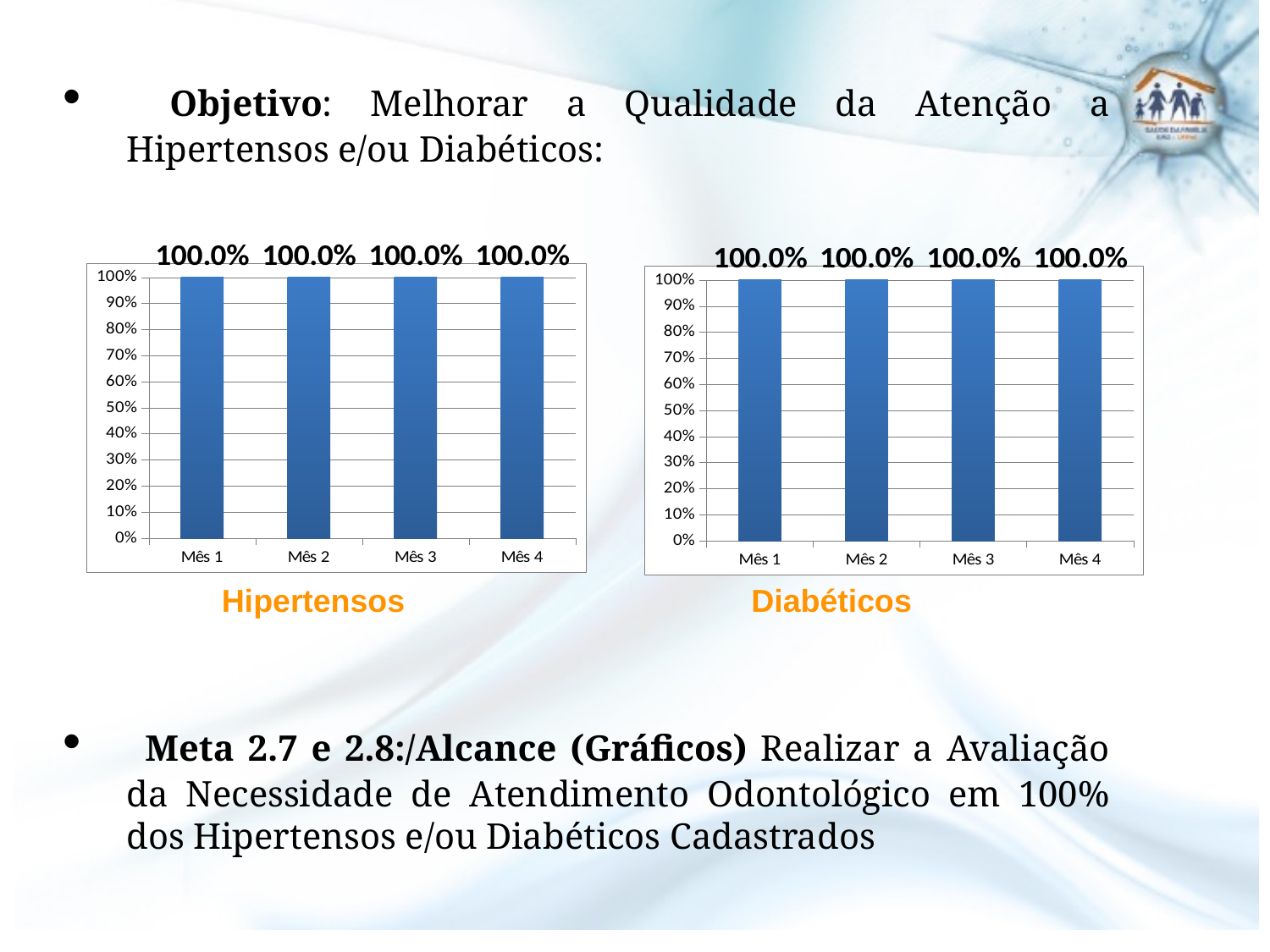
In the Diabéticos chart, what is the value for Mês 2? 100.0% In the Hipertensos chart, what is the value for Mês 3? 100.0% How many categories are shown on the x axis of the Hipertensos chart? 4 In the Hipertensos chart, do the values rise, fall or stay the same from Mês 1 to Mês 4? stay the same In the Diabéticos chart, what is the value for Mês 4? 100.0% How many charts are shown on the slide? 2 In the Hipertensos chart, what is the value for Mês 1? 100.0% In the Diabéticos chart, is the value for Mês 3 greater or less than 90%? greater In the Diabéticos chart, what is the difference between the values for Mês 1 and Mês 4? 0.0% How many bars does the Diabéticos chart have? 4 What label appears below the chart on the right side of the slide? Diabéticos What kind of chart is the Hipertensos chart? bar chart